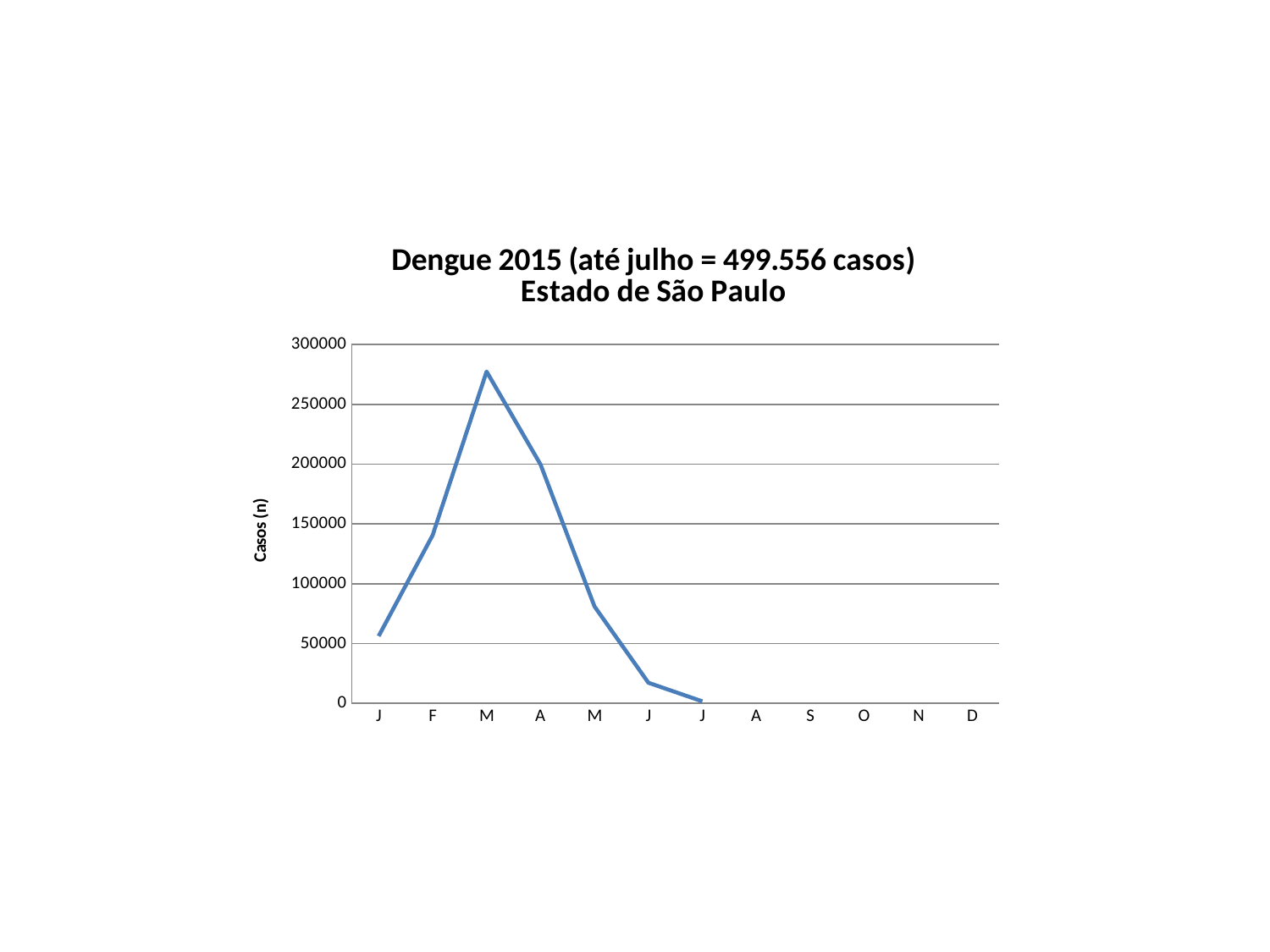
Is the value for March (the first M) greater or less than 250000? greater Do the values rise or fall from March (the first M) to July (the third J)? fall What is the title of the chart? Dengue 2015 (até julho = 499.556 casos) Estado de São Paulo Is the value for May (the second M) greater or less than 100000? less Among the months with plotted data, which has the lowest number of cases? J (July, the third J) Which month has the highest number of cases? M (March, the first M) Is the value for January (the first J) greater or less than 100000? less How many month labels are shown along the x axis? 12 Which has more cases, February (F) or April (A)? April (A) For how many months does the line show plotted data? 7 What kind of chart is shown on the slide? line chart What is the label on the vertical axis? Casos (n)